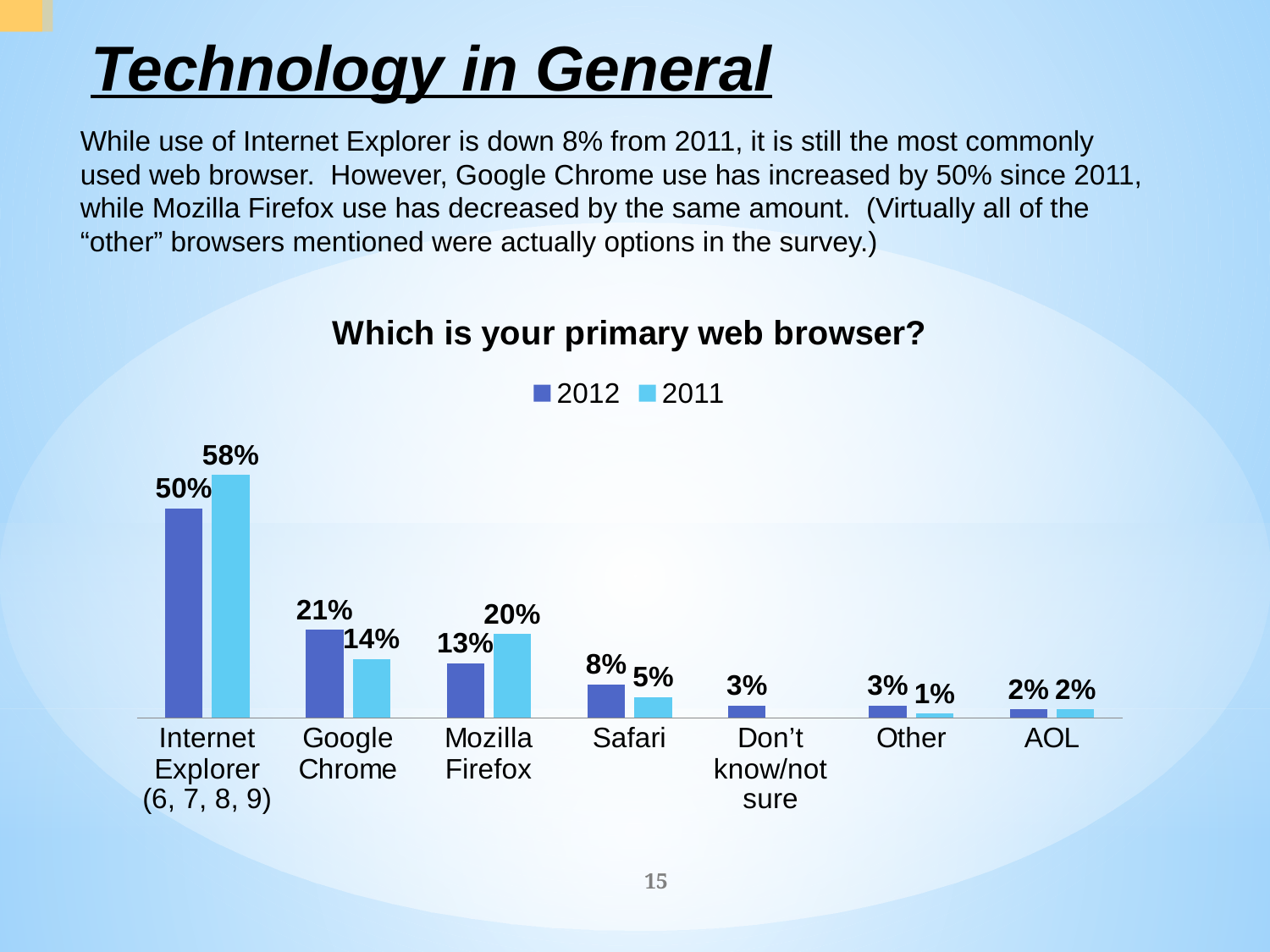
Which browser has the highest value in the 2012 series? Internet Explorer (6, 7, 8, 9) What type of chart is used to show the primary web browser data? Bar chart What percentage of respondents chose Internet Explorer as their primary web browser in 2012? 50% Which category has the lowest value in the 2011 series among those with a labelled bar? Other By how many percentage points did Internet Explorer's share fall from 2011 to 2012? 8% What is the 2012 value for Safari? 8% How many browser categories are shown on the x axis? 7 What percentage chose Mozilla Firefox in 2011? 20% How many series does the legend list? 2 What is the difference between the 2012 and 2011 values for Google Chrome? 7% Which is larger for Mozilla Firefox: the 2012 value or the 2011 value? 2011 What was the 2011 value for Google Chrome? 14%